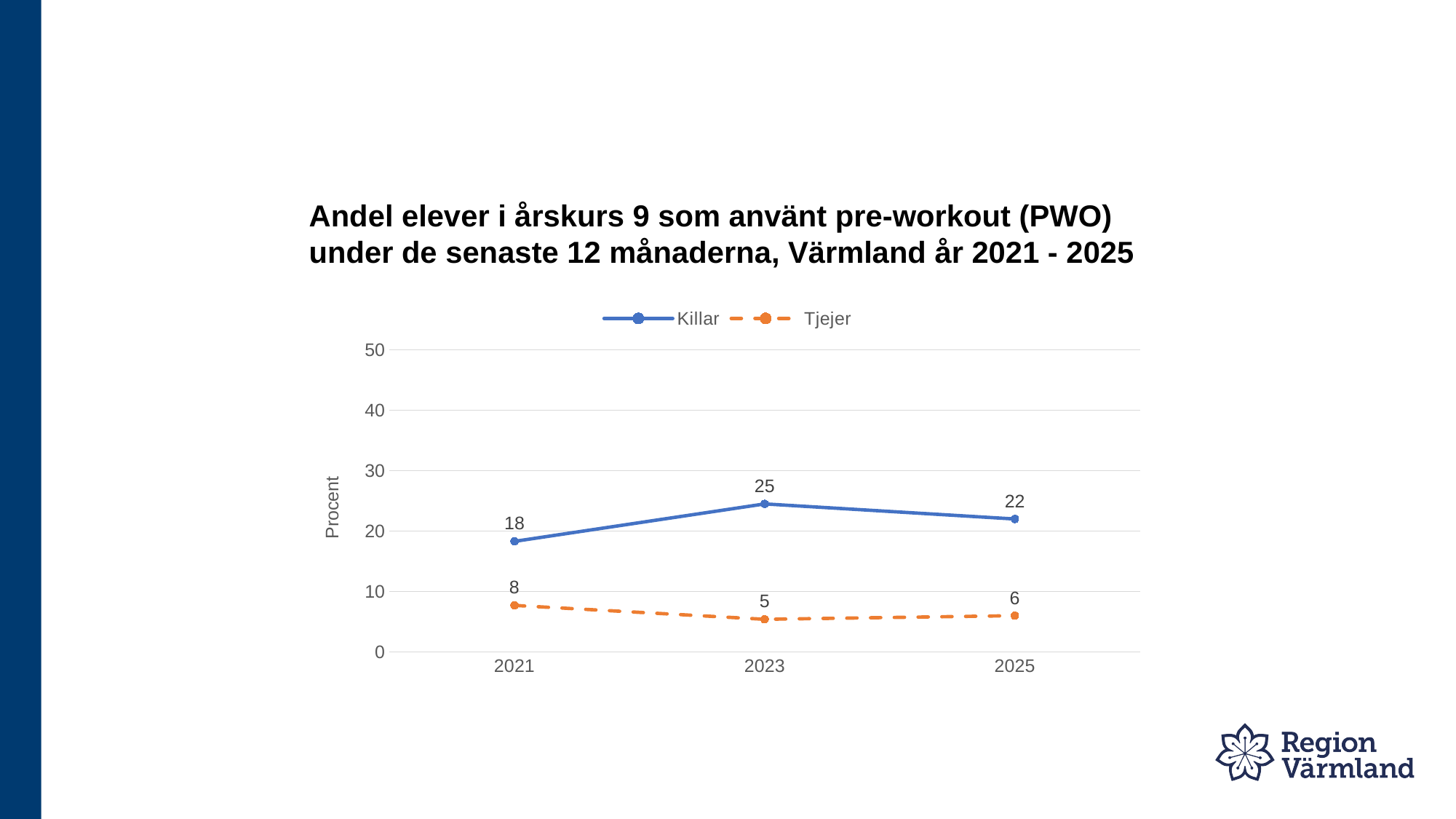
Is the value for Killar in 2021 greater or less than 10? greater What is the label on the y axis? Procent What is the value for Killar in 2023? 25 Which series has the larger value in 2021, Killar or Tjejer? Killar What is the value for Killar in 2025? 22 How many years are shown on the x axis? 3 What kind of chart is shown on the slide? Line chart In which year is the value for Tjejer lowest? 2023 What is the difference between the Killar and Tjejer values in 2025? 16 In which year is the value for Killar highest? 2023 How many series does the legend list? 2 What is the value for Tjejer in 2021? 8